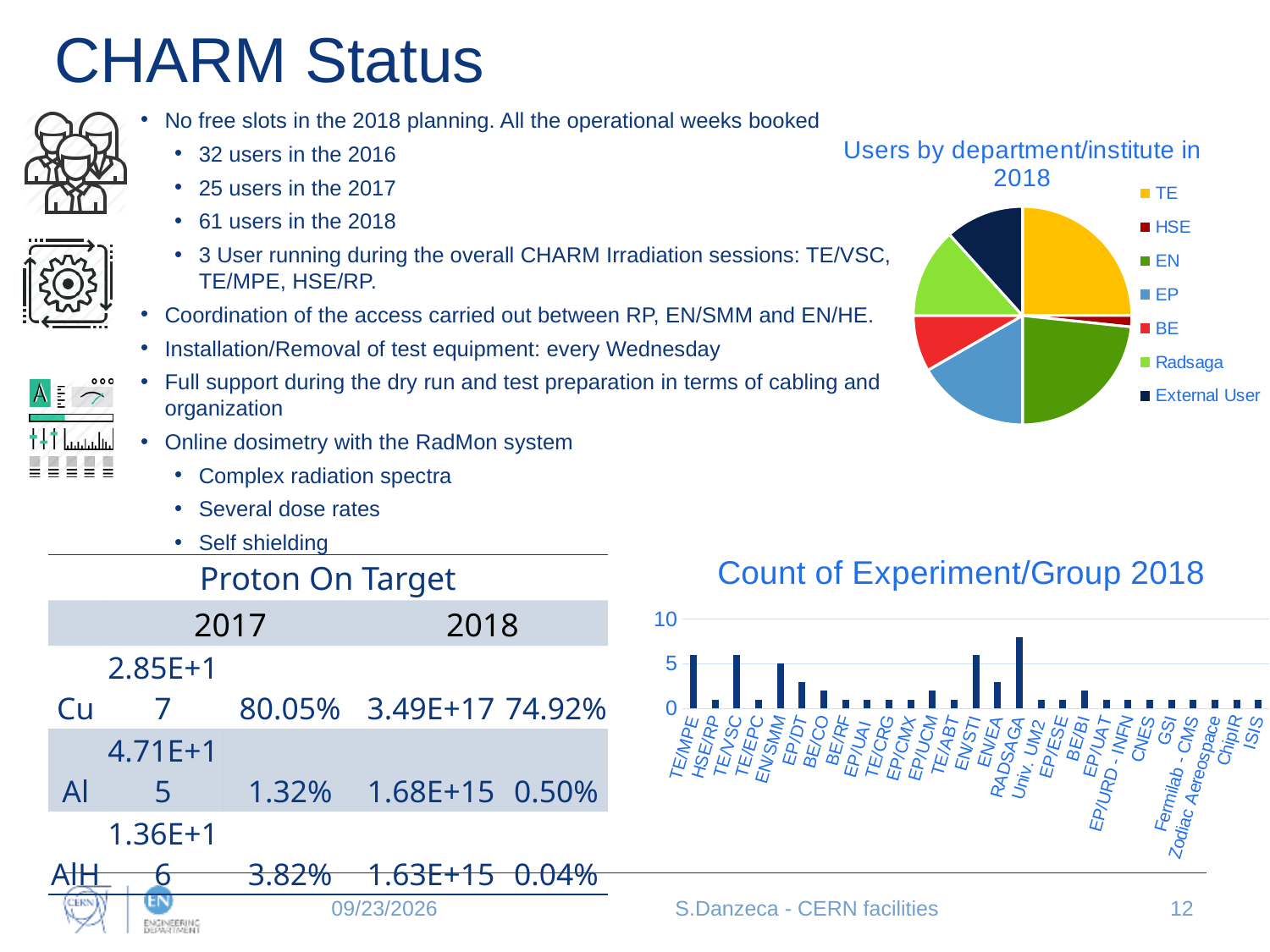
How many entries does the legend of the 'Users by department/institute in 2018' pie chart list? 7 In the 'Users by department/institute in 2018' pie chart, which category has the smallest slice? HSE How many groups are shown on the x axis of the 'Count of Experiment/Group 2018' chart? 27 In the 'Users by department/institute in 2018' pie chart, what colour represents TE? yellow In the 'Count of Experiment/Group 2018' chart, is the value for Univ. UM2 greater or less than 5? less In the 'Count of Experiment/Group 2018' chart, is the value for HSE/RP greater or less than 5? less What kind of chart is the 'Users by department/institute in 2018' chart? pie chart In the 'Count of Experiment/Group 2018' chart, is the value for TE/MPE greater or less than 5? greater In the 'Count of Experiment/Group 2018' chart, which group has the highest count? RADSAGA What kind of chart is the 'Count of Experiment/Group 2018' chart? bar chart